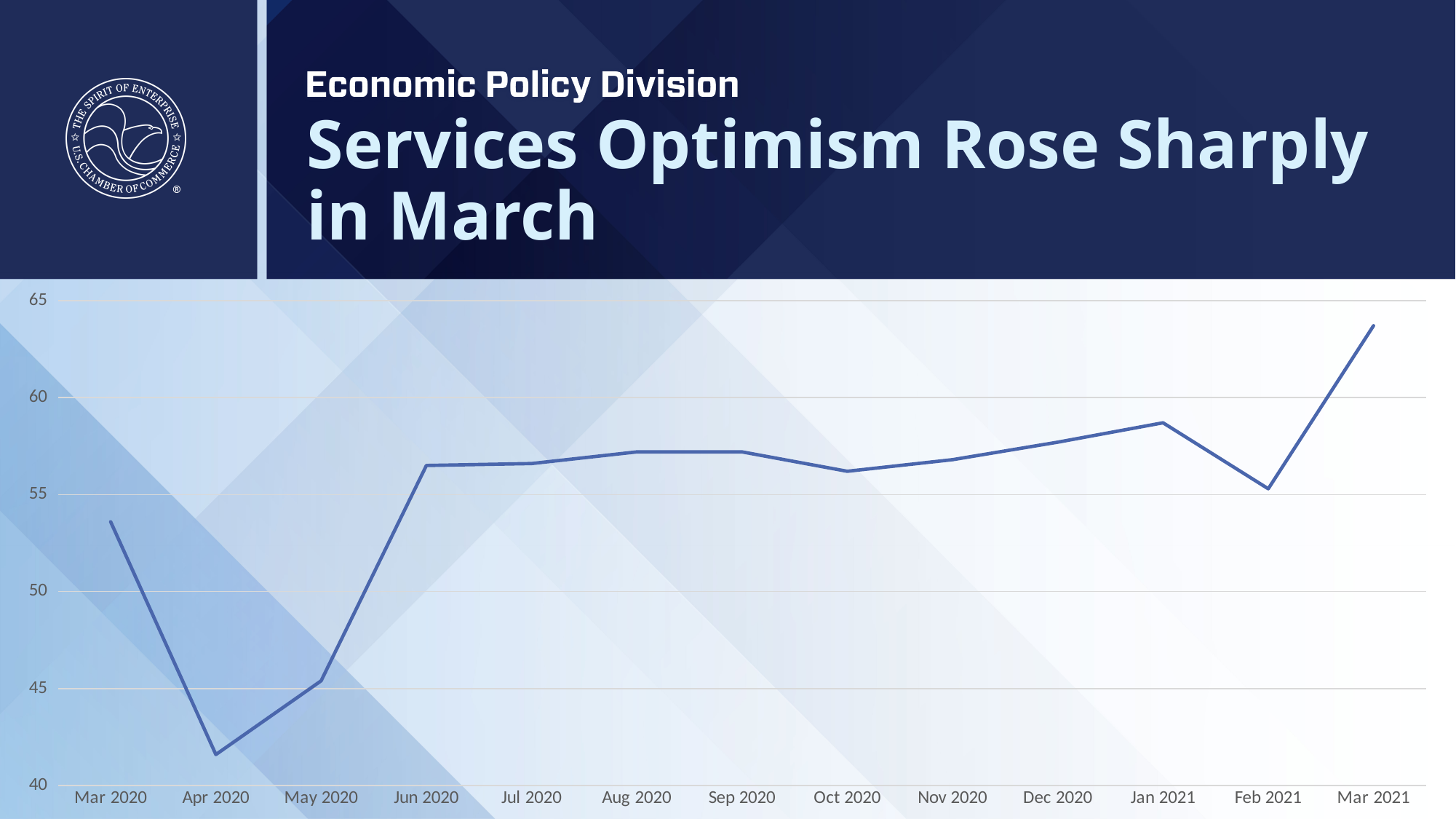
How many months are plotted along the x axis? 13 What is the title of the slide containing the chart? Services Optimism Rose Sharply in March Is the value for Apr 2020 greater or less than 45? less Which month has the lowest value? Apr 2020 What kind of chart is shown on the slide? line chart Which is larger, the value for May 2020 or the value for Jun 2020? Jun 2020 Which is larger, the value for Jan 2021 or the value for Feb 2021? Jan 2021 Which month has the highest value? Mar 2021 Is the value for Mar 2020 greater or less than 55? less Does the line rise or fall from Feb 2021 to Mar 2021? rise Is the value for Mar 2021 greater or less than 60? greater